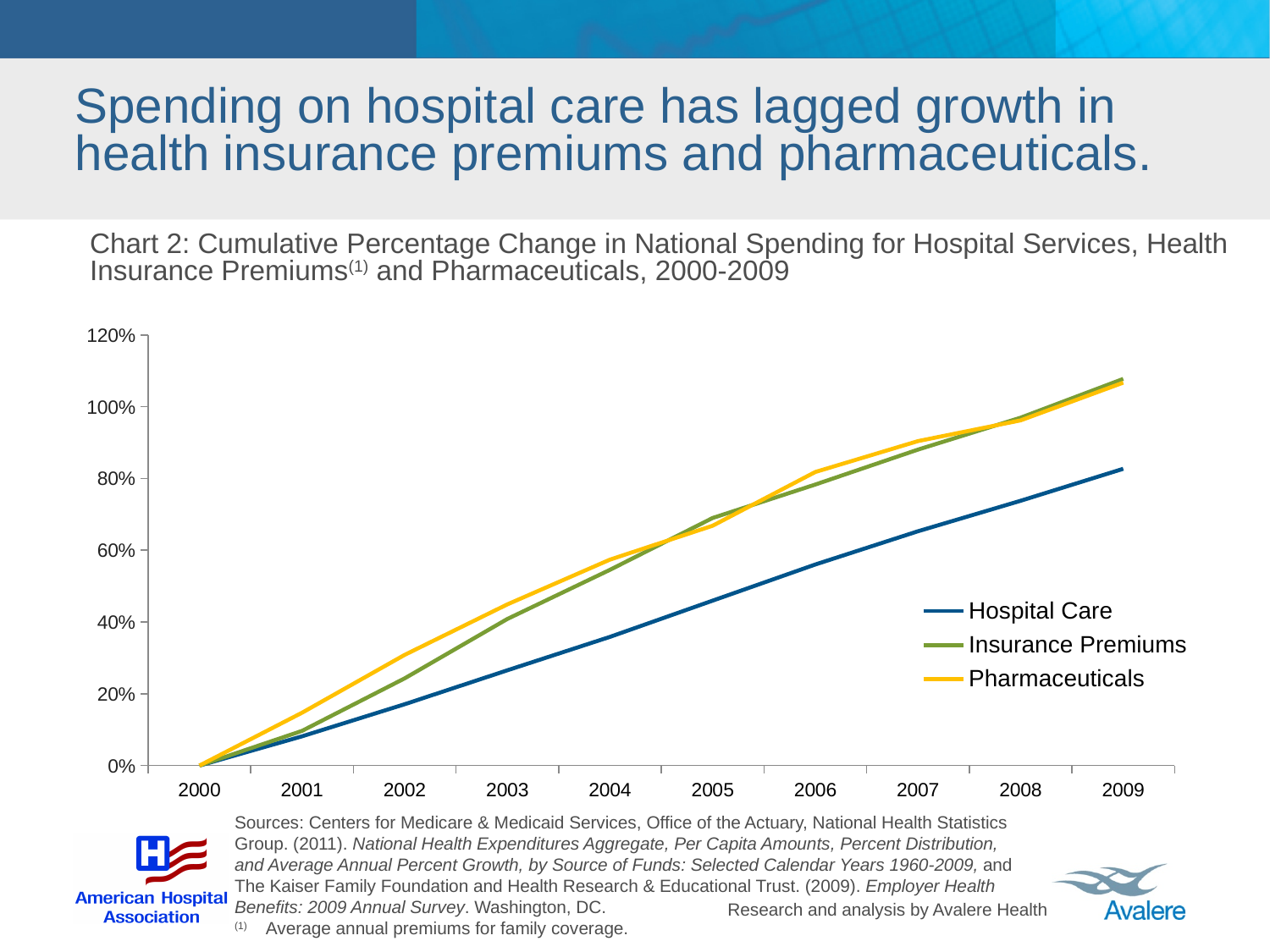
What is the value for Hospital Care in 2000? 0% Which series has the lowest value in 2009? Hospital Care Is the value for Insurance Premiums in 2009 greater or less than 100%? greater Is the value for Hospital Care in 2009 greater or less than 100%? less How many years are shown on the x axis? 10 Which series is drawn in yellow? Pharmaceuticals What kind of chart is shown on the slide? line chart Is the value for Hospital Care in 2005 greater or less than 60%? less In 2004, which is larger: Pharmaceuticals or Hospital Care? Pharmaceuticals How many series does the legend list? 3 In 2009, which is larger: Hospital Care or Insurance Premiums? Insurance Premiums Do the values for Hospital Care rise or fall from 2000 to 2009? rise